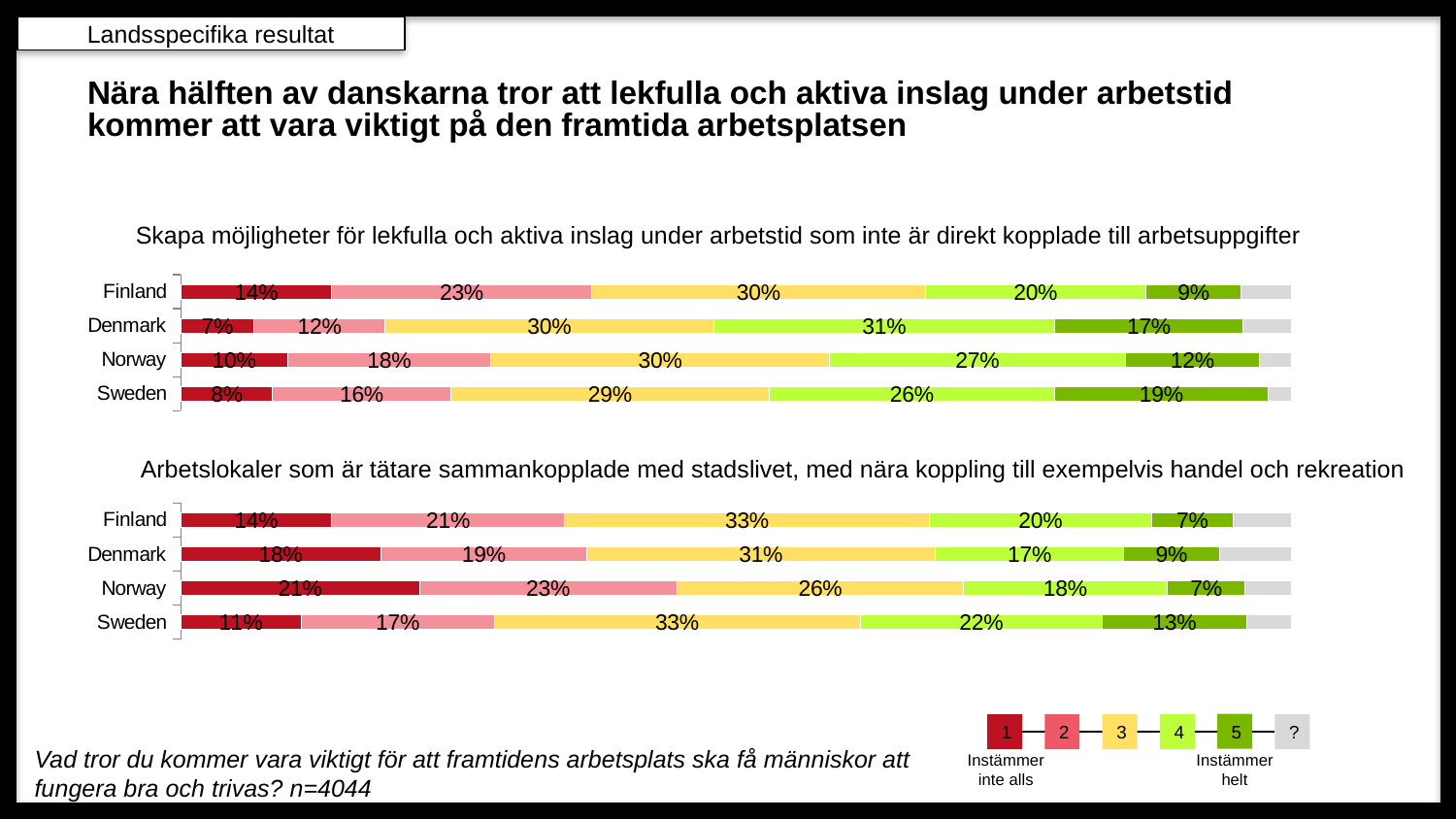
In the top chart (Skapa möjligheter för lekfulla och aktiva inslag...), what percentage of respondents in Denmark chose 4? 31% In the bottom chart (Arbetslokaler som är tätare sammankopplade med stadslivet...), what percentage of respondents in Norway chose 1 (Instämmer inte alls)? 21% In the top chart (Skapa möjligheter för lekfulla och aktiva inslag...), which country has the lowest share for 5 (Instämmer helt)? Finland In the top chart (Skapa möjligheter för lekfulla och aktiva inslag...), which country has the highest share for 1 (Instämmer inte alls)? Finland How many entries does the legend at the bottom right of the slide list? 6 How many countries are shown in the top chart (Skapa möjligheter för lekfulla och aktiva inslag...)? 4 In the bottom chart (Arbetslokaler som är tätare sammankopplade med stadslivet...), what is the difference between Sweden's and Norway's share for 3? 7 percentage points What type of chart is used for the bottom chart (Arbetslokaler som är tätare sammankopplade med stadslivet...)? Stacked bar chart In the bottom chart (Arbetslokaler som är tätare sammankopplade med stadslivet...), which is larger: Denmark's share for 1 or Sweden's share for 1? Denmark In the bottom chart (Arbetslokaler som är tätare sammankopplade med stadslivet...), which country has the highest share for 5 (Instämmer helt)? Sweden In the top chart (Skapa möjligheter för lekfulla och aktiva inslag...), what is the difference between Denmark's and Finland's share for 4? 11 percentage points In the top chart (Skapa möjligheter för lekfulla och aktiva inslag...), what percentage of respondents in Sweden chose 5 (Instämmer helt)? 19%